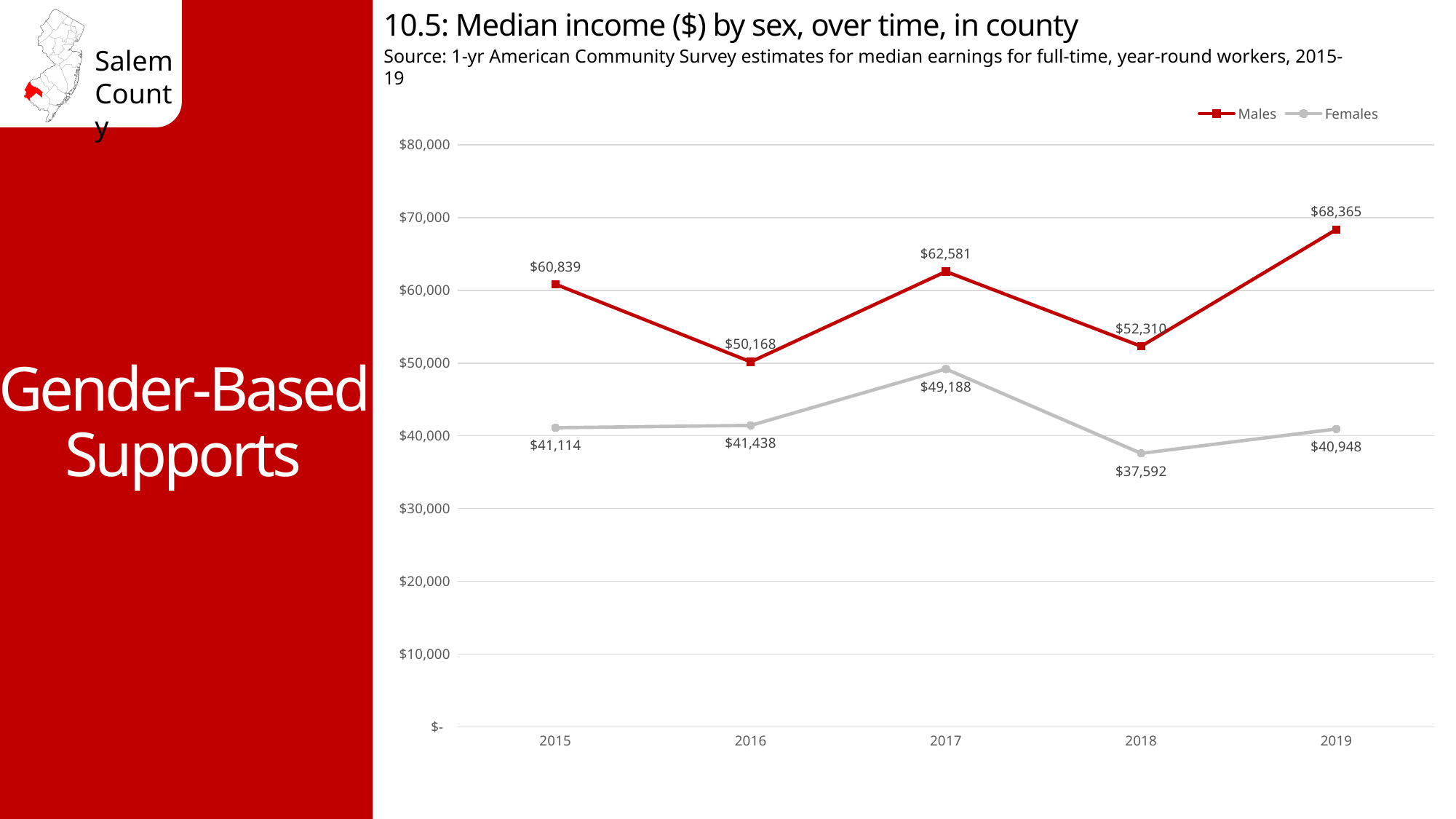
What was the median income for Females in 2018? $37,592 What colour is the line for Males? Red What is the difference between the Males and Females median income in 2017? $13,393 In which year was the median income for Males highest? 2019 What kind of chart is shown on the slide? Line chart What was the median income for Males in 2016? $50,168 How many years are shown on the x axis? 5 How many series does the legend list? 2 In which year was the median income for Females lowest? 2018 Did the median income for Males rise or fall from 2018 to 2019? Rise Which was larger in 2015, the median income for Males or for Females? Males What was the median income for Males in 2019? $68,365